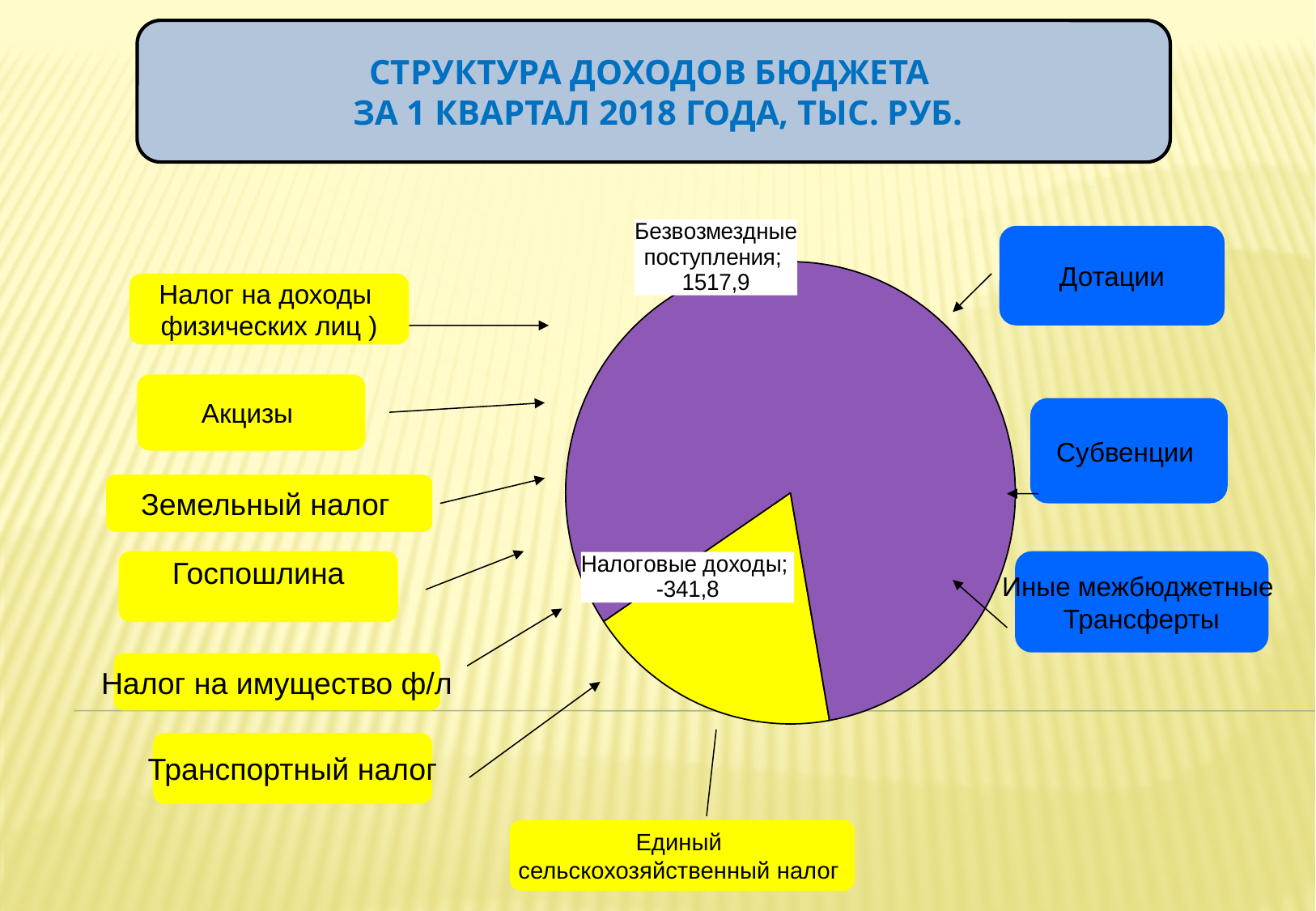
What type of chart is shown on the slide? Pie chart What is the title of the chart on the slide? СТРУКТУРА ДОХОДОВ БЮДЖЕТА ЗА 1 КВАРТАЛ 2018 ГОДА, ТЫС. РУБ. How many slices does the pie chart have? 2 What value is shown for Безвозмездные поступления in the pie chart? 1517,9 Which is larger in the pie chart: Безвозмездные поступления or Налоговые доходы? Безвозмездные поступления What value is shown for Налоговые доходы in the pie chart? -341,8 Which slice of the pie chart has the largest value? Безвозмездные поступления Which slice of the pie chart has the smallest value? Налоговые доходы What colour is the Налоговые доходы slice in the pie chart? Yellow